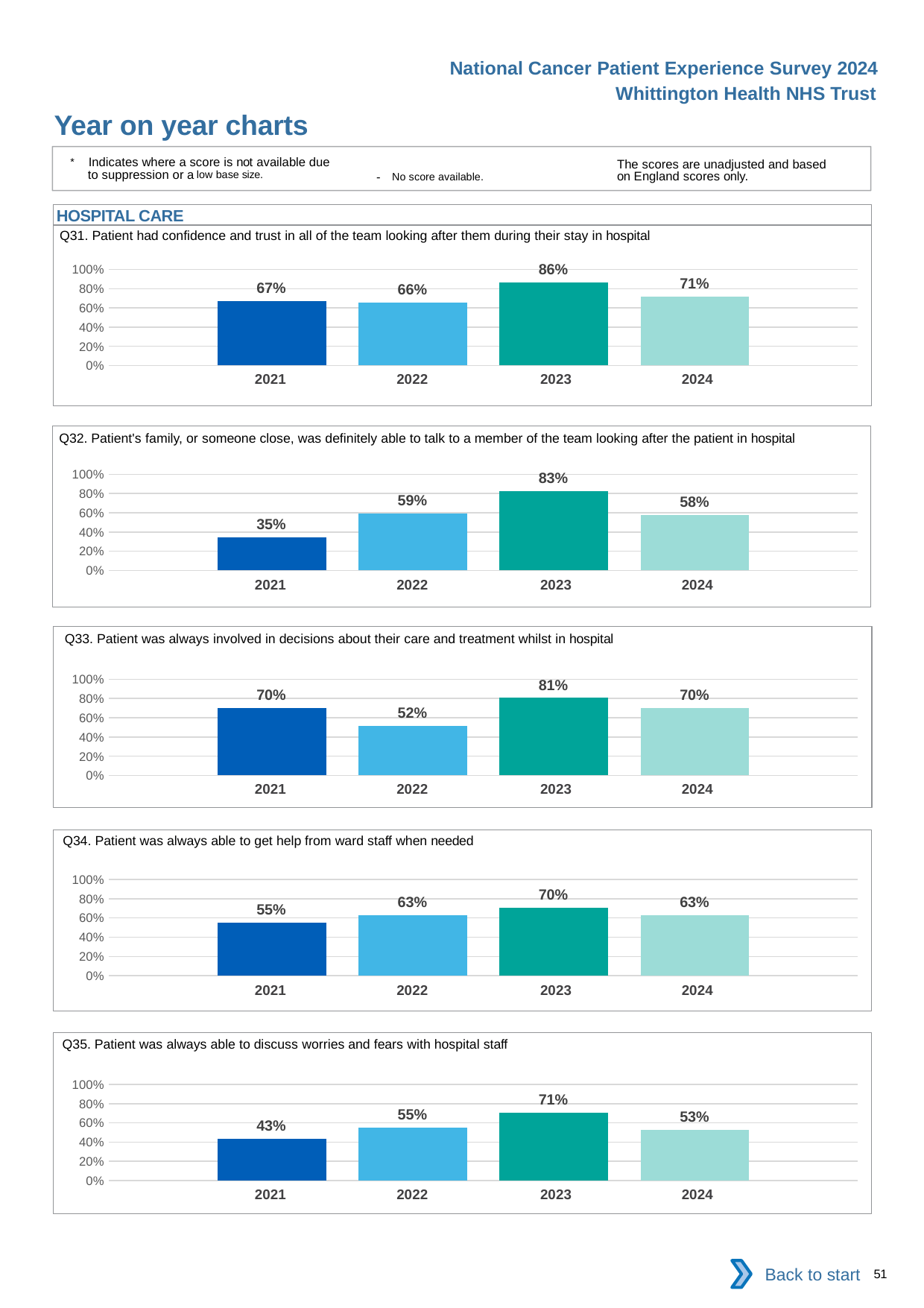
In the Q34 chart, what is the value for 2023? 70% What kind of chart is the Q35 chart? bar chart In the Q33 chart, which year has the highest value? 2023 In the Q35 chart, what is the difference between the 2022 and 2021 values? 12 percentage points In the Q34 chart, is the value for 2021 larger or smaller than the value for 2022? smaller In the Q35 chart, is the value for 2024 greater or less than 60%? less In the Q32 chart, what is the difference between the 2023 and 2024 values? 25 percentage points In the Q33 chart, what is the value for 2022? 52% In the Q32 chart, which year has the lowest value? 2021 In the Q31 chart, what is the value for 2024? 71% In the Q31 chart, what is the value for 2023? 86% How many years are shown in the Q31 chart? 4